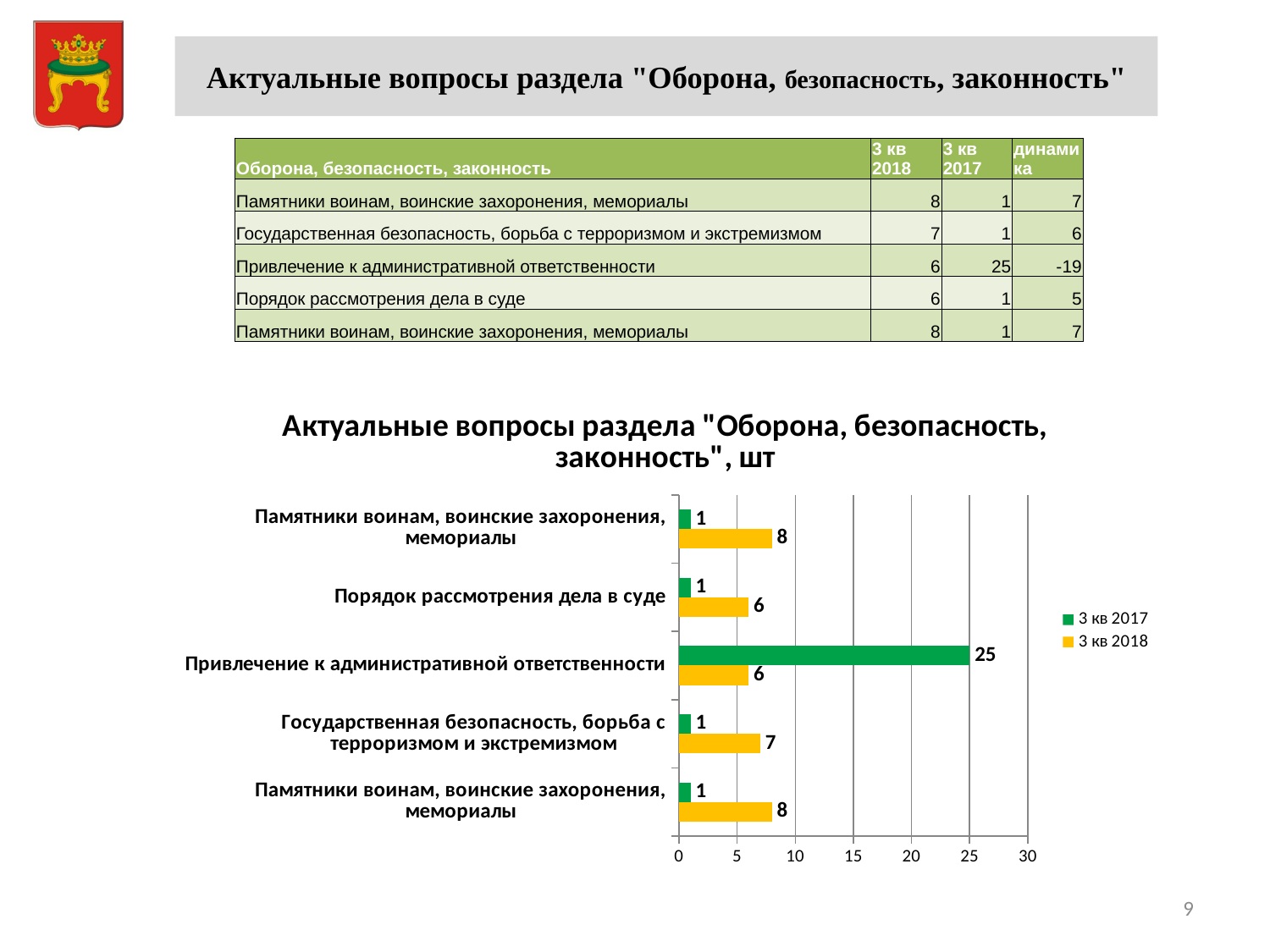
What type of chart is shown on the slide? bar chart Which category has the highest value in the 3 кв 2017 series? Привлечение к административной ответственности Is the 3 кв 2017 value for "Привлечение к административной ответственности" greater or less than 20? greater For "Привлечение к административной ответственности", how much larger is the 3 кв 2017 value than the 3 кв 2018 value? 19 What is the 3 кв 2017 value for "Порядок рассмотрения дела в суде"? 1 What is the 3 кв 2018 value for "Государственная безопасность, борьба с терроризмом и экстремизмом"? 7 For "Государственная безопасность, борьба с терроризмом и экстремизмом", which series has the larger value, 3 кв 2017 or 3 кв 2018? 3 кв 2018 How many categories are shown on the chart's vertical axis? 5 What is the value for "Порядок рассмотрения дела в суде" in the 3 кв 2018 series? 6 How many series does the chart legend list? 2 What is the value for "Привлечение к административной ответственности" in the 3 кв 2017 series? 25 Which category has the highest value in the 3 кв 2018 series? Памятники воинам, воинские захоронения, мемориалы